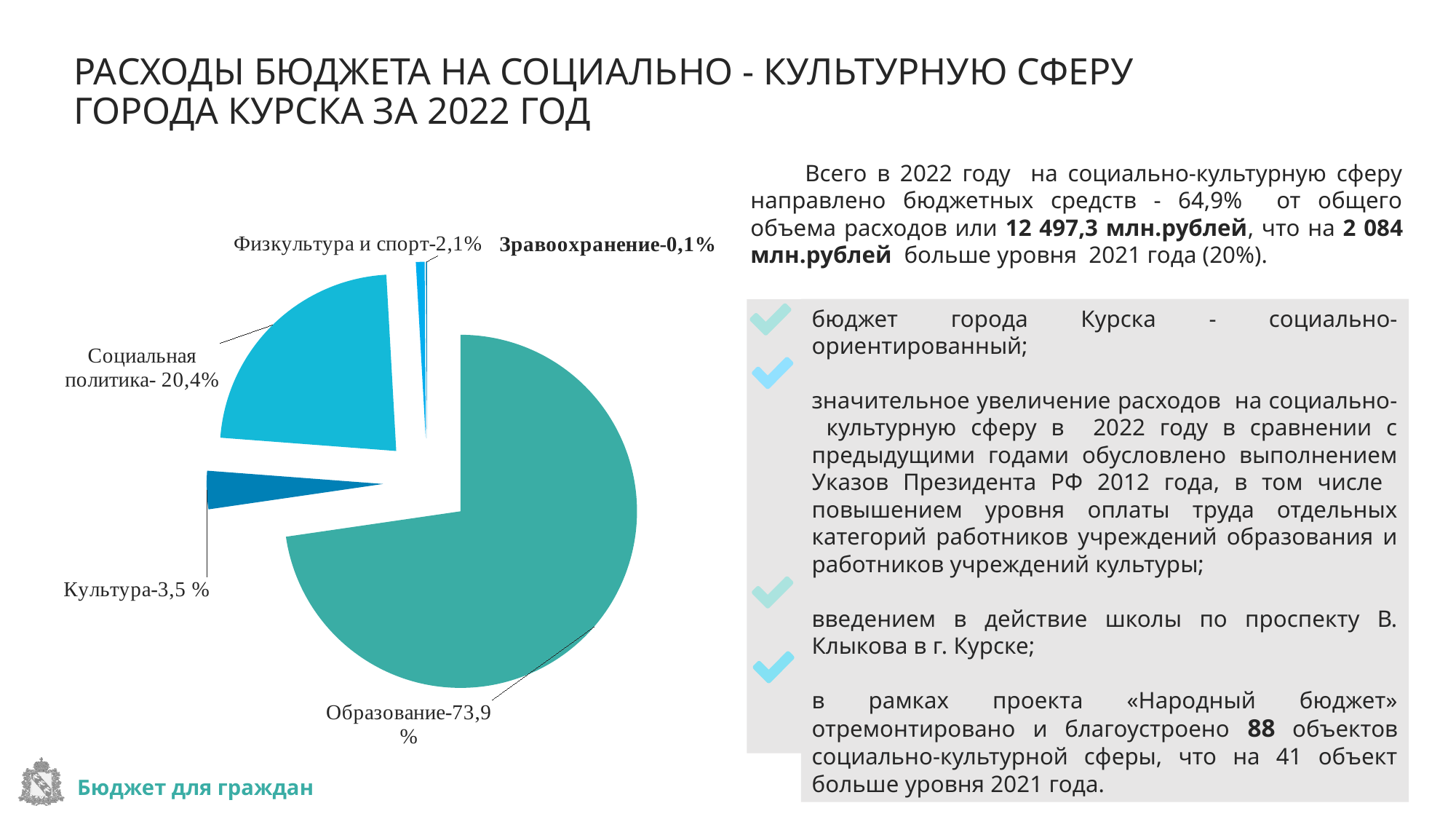
What share of the pie does Образование account for? 73,9% What is the value shown for Социальная политика? 20,4% Which category has the largest slice of the pie? Образование What is the difference in percentage points between Культура and Физкультура и спорт? 1,4 What is the value shown for Физкультура и спорт? 2,1% What is the difference in percentage points between Образование and Социальная политика? 53,5 What kind of chart is shown on the slide? pie chart Which category has the smallest slice of the pie? Зравоохранение How many slices does the pie chart have? 5 What is the value shown for Зравоохранение? 0,1% What is the value shown for Культура? 3,5 % Which is larger, the slice for Социальная политика or the slice for Культура? Социальная политика